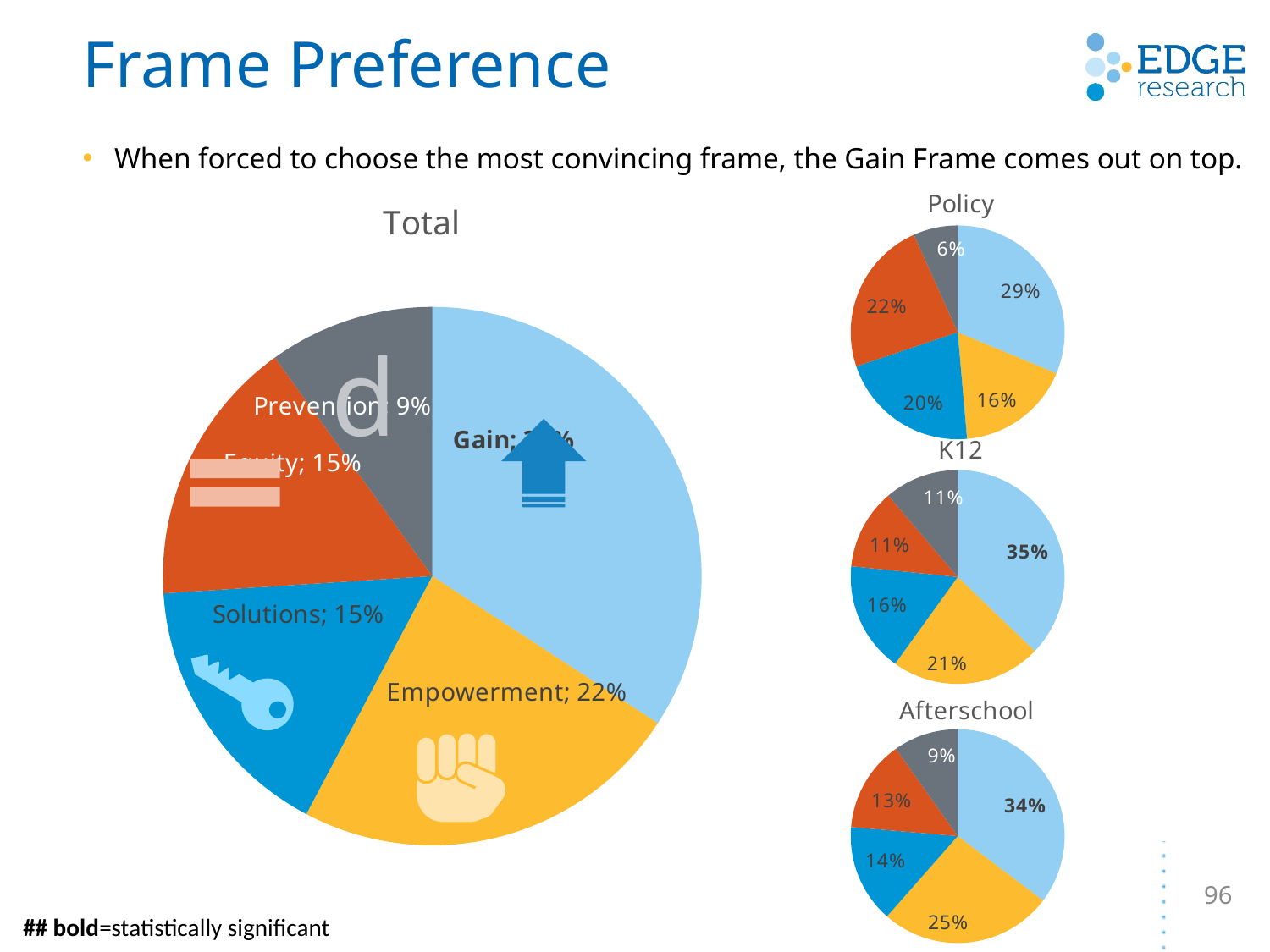
In the Total pie chart, what is the value for Empowerment? 22% In the Total pie chart, what is the difference between the Empowerment and Solutions values? 7 percentage points In the Total pie chart, what is the value for Prevention? 9% How many slices does the Total pie chart have? 5 In the Total pie chart, what is the value for Solutions? 15% In the Policy pie chart, what is the value of the smallest slice? 6% In the K12 pie chart, what is the value of the largest slice? 35% In the Afterschool pie chart, what is the value of the yellow slice? 25% In the Afterschool pie chart, what is the value of the smallest slice? 9% Which chart has the larger light blue slice, K12 or Afterschool? K12 In the Policy pie chart, what is the value of the largest slice? 29% What kind of chart is the Total chart? Pie chart